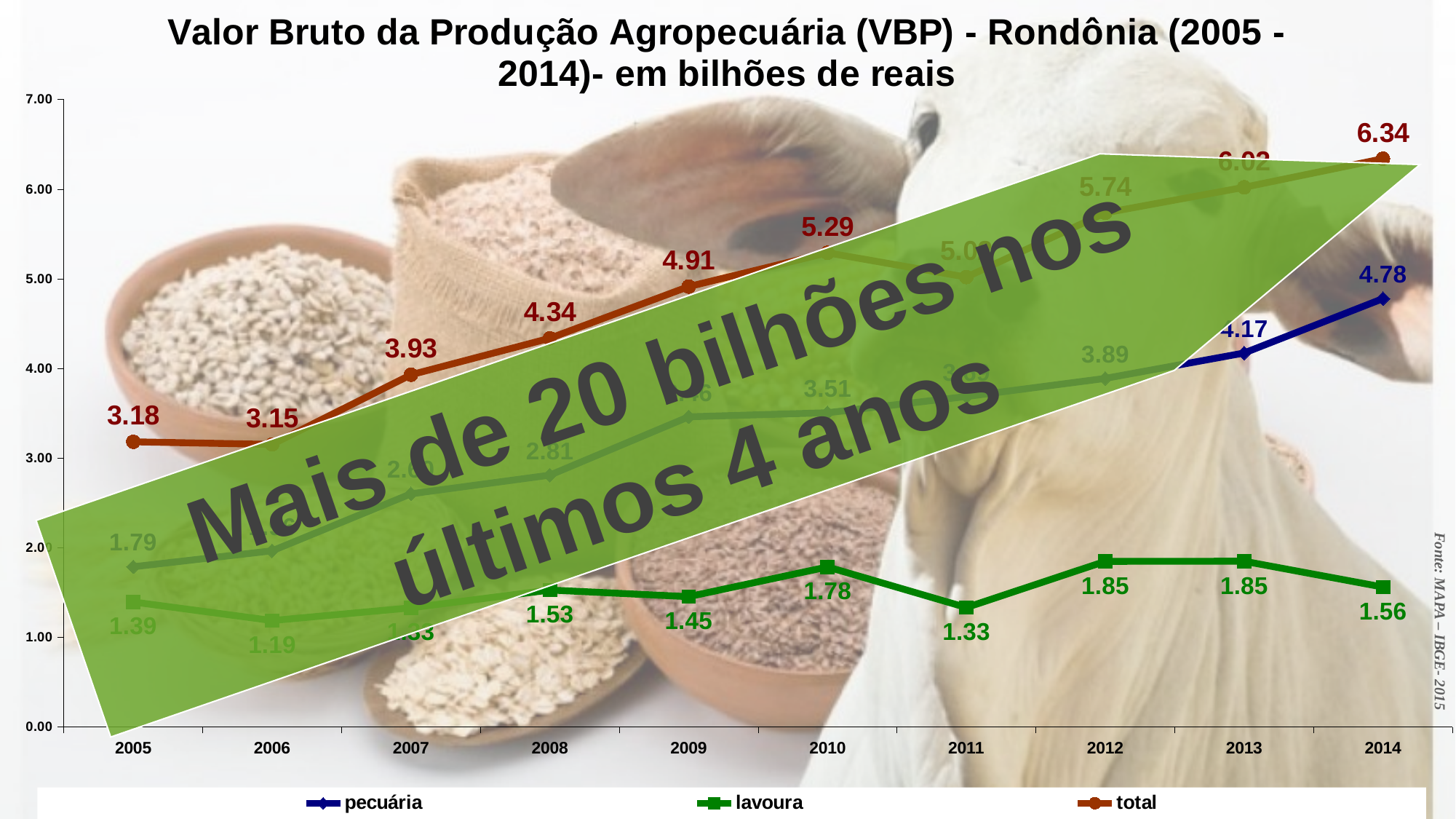
Which is larger in 2014, the pecuária value or the lavoura value? pecuária What type of chart is shown on the slide? line chart Does the total series generally rise or fall from 2005 to 2014? rise What is the value of the pecuária series in 2013? 4.17 What is the difference between the total value in 2014 and in 2005? 3.16 How many years are plotted along the x axis? 10 What is the value of the total series in 2014? 6.34 How many series does the legend list? 3 What is the value of the lavoura series in 2011? 1.33 In which year is the lavoura series at its lowest? 2006 In which year is the total series at its highest? 2014 Is the value of the total series in 2012 greater or less than 5.00? greater